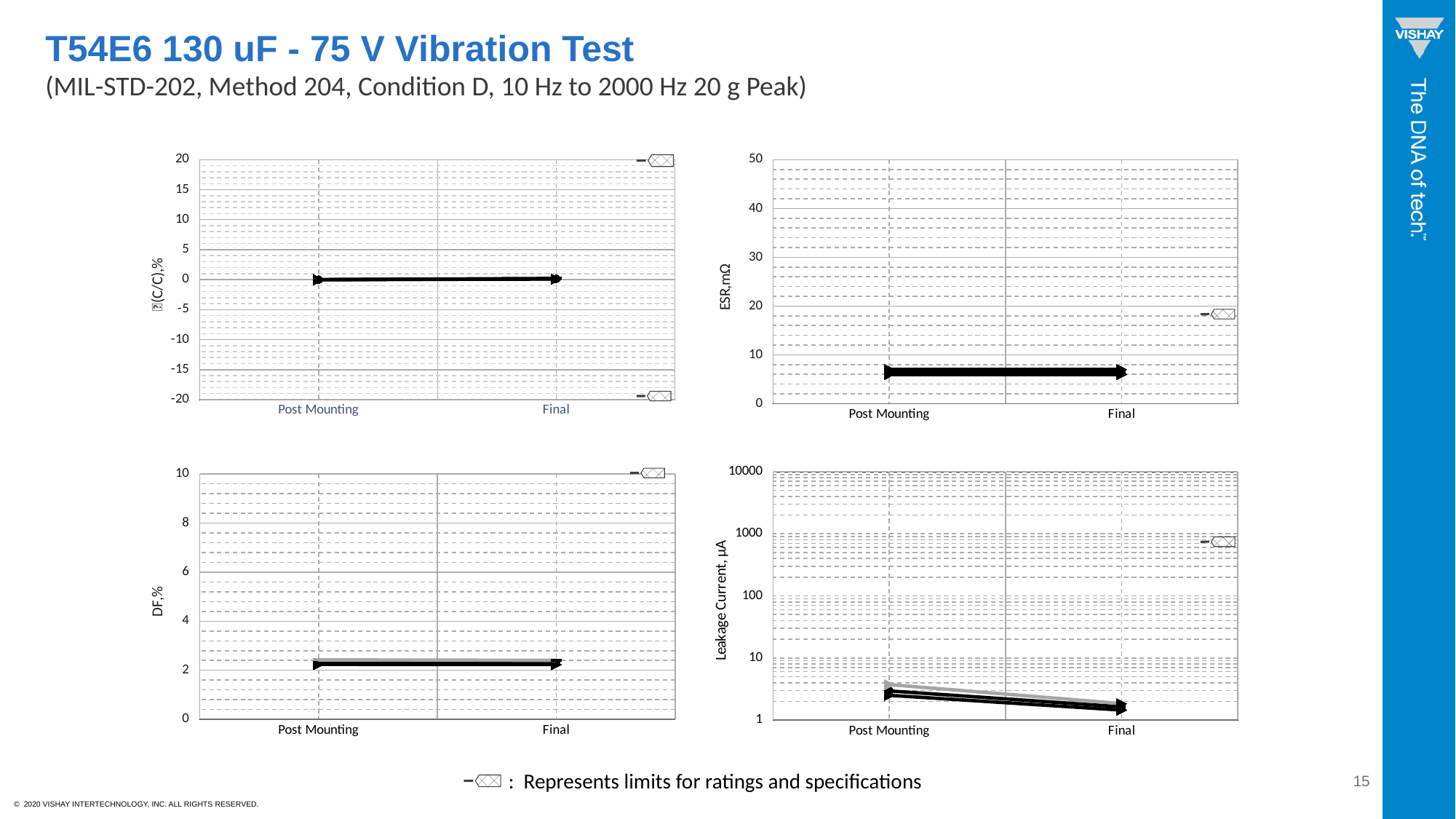
In the ESR chart (top right), is the value at Post Mounting greater or less than 10? less In the Leakage Current chart (bottom right), do the values rise or fall from Post Mounting to Final? fall What is the y-axis label of the top-right chart? ESR,mΩ How many categories are shown on the x axis of the ESR chart (top right)? 2 In the ESR chart (top right), is the limit marker greater or less than 20? less According to the legend at the bottom of the slide, what does the hatched marker represent? Limits for ratings and specifications In the Leakage Current chart (bottom right), is the limit marker greater or less than 100? greater What kind of chart is the top-left chart (ΔC/C, %)? line chart